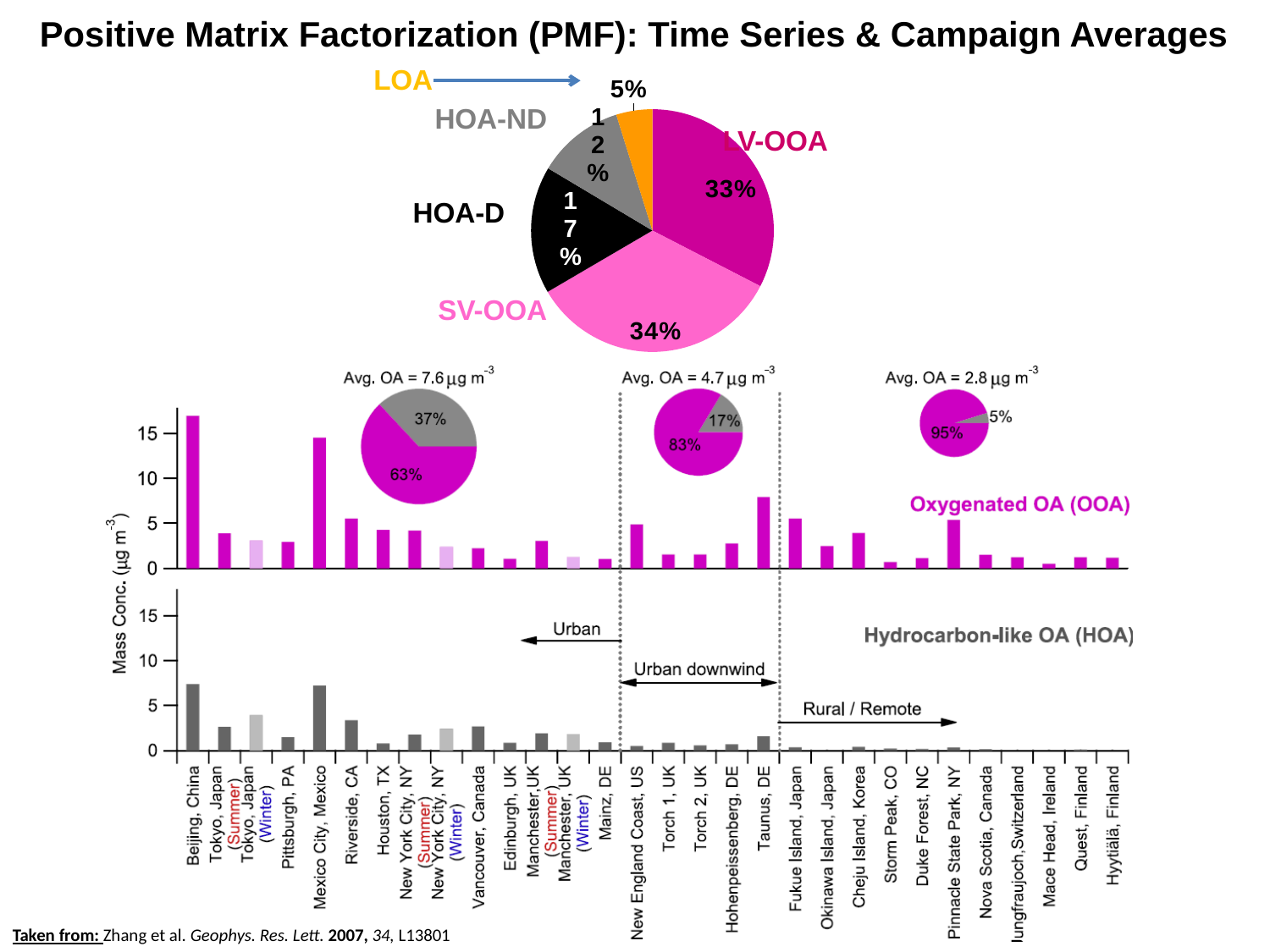
In the top pie chart, what is the difference in percentage points between the SV-OOA and LV-OOA slices? 1 In the lower figure, is the Oxygenated OA (OOA) value for Beijing, China greater or less than 15? greater In the lower figure, is the Hydrocarbon-like OA (HOA) value for Beijing, China greater or less than 5? greater In the top pie chart, which slice is larger, HOA-D or HOA-ND? HOA-D In the lower figure, what is the average OA concentration given for the Rural / Remote group of sites? 2.8 µg m-3 What kind of chart is used in the lower figure to show mass concentration by site? Bar chart In the top pie chart, which component has the smallest slice? LOA In the top pie chart, what percentage is shown for the LV-OOA slice? 33% In the small pie chart above the Urban sites in the lower figure, what percentage is shown for the OOA (magenta) slice? 63% In the top pie chart, how many slices are there? 5 In the top pie chart, which component has the largest slice? SV-OOA In the top pie chart, what percentage is shown for the SV-OOA slice? 34%